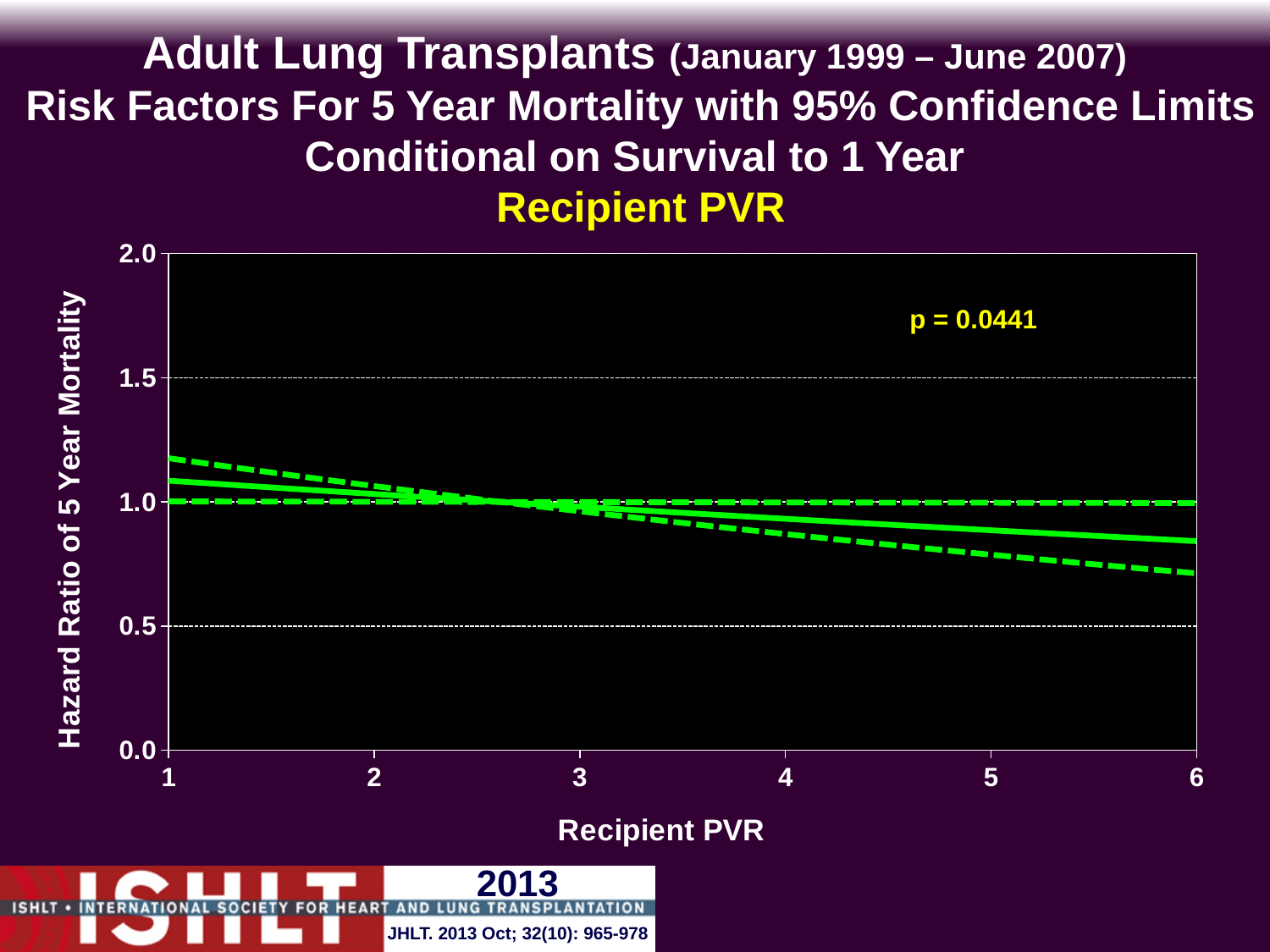
At a Recipient PVR of 1, is the solid hazard ratio line greater or less than 1.0? greater What is the label of the y-axis? Hazard Ratio of 5 Year Mortality How many lines are plotted on the chart? 3 Is the solid hazard ratio line higher at a Recipient PVR of 1 or at a Recipient PVR of 6? 1 At a Recipient PVR of 6, is the lower dashed confidence limit greater or less than 0.5? greater What kind of chart is shown on the slide? line chart What p-value is printed on the chart? p = 0.0441 At a Recipient PVR of 1, is the upper dashed confidence limit greater or less than 1.5? less Does the solid hazard ratio line rise or fall as Recipient PVR increases from 1 to 6? fall